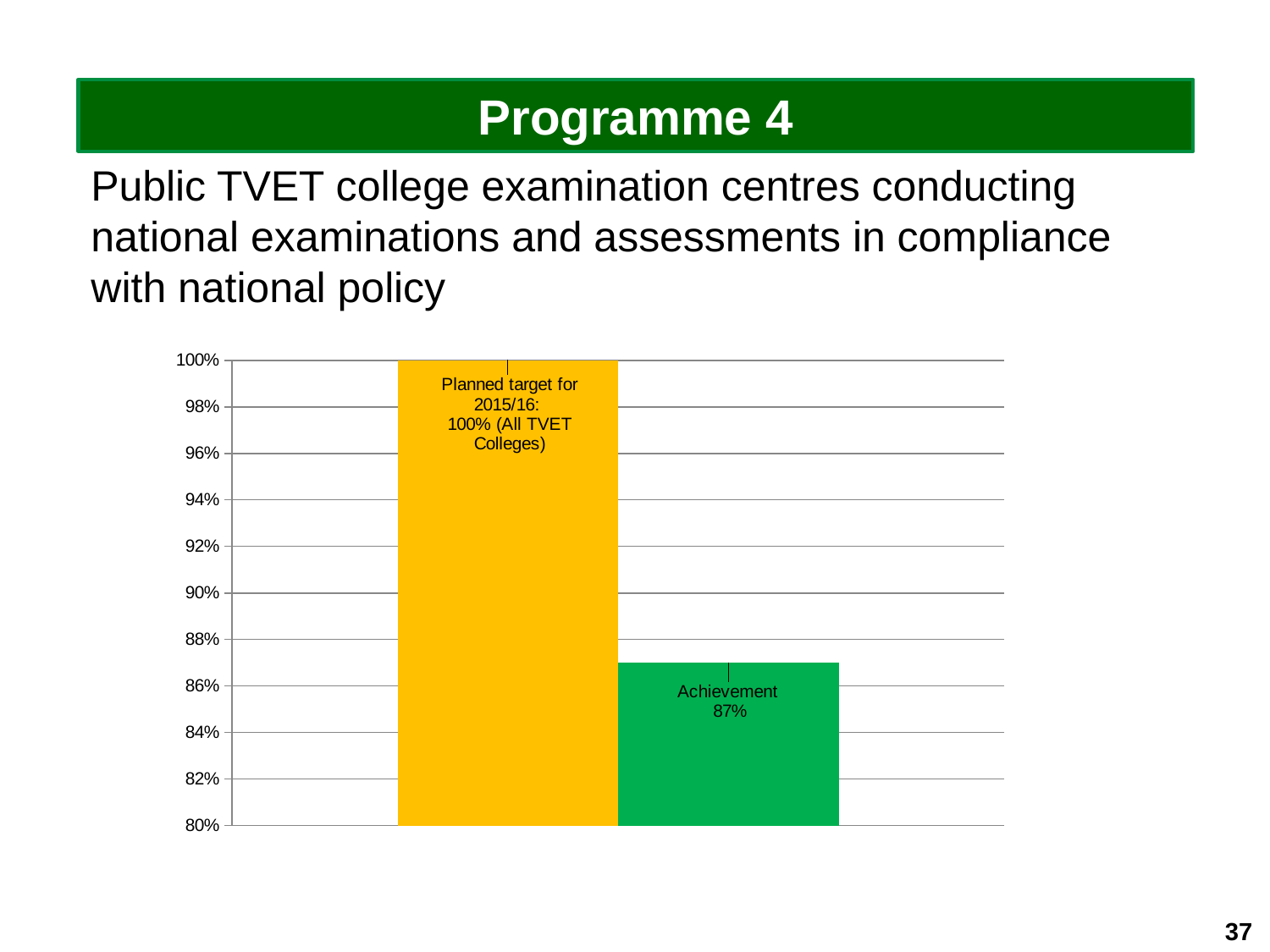
What kind of chart is shown on the slide? Bar chart What is the achievement value shown on the chart? 87% What is the lowest value shown on the vertical axis? 80% Is the achievement value greater or less than 90%? less Which bar is higher, the planned target or the achievement? Planned target What is the difference between the planned target and the achievement? 13% What colour is the bar for the achievement? Green Which bar shows the lowest value on the chart? Achievement How many bars are plotted on the chart? 2 What is the planned target for 2015/16 shown on the chart? 100%